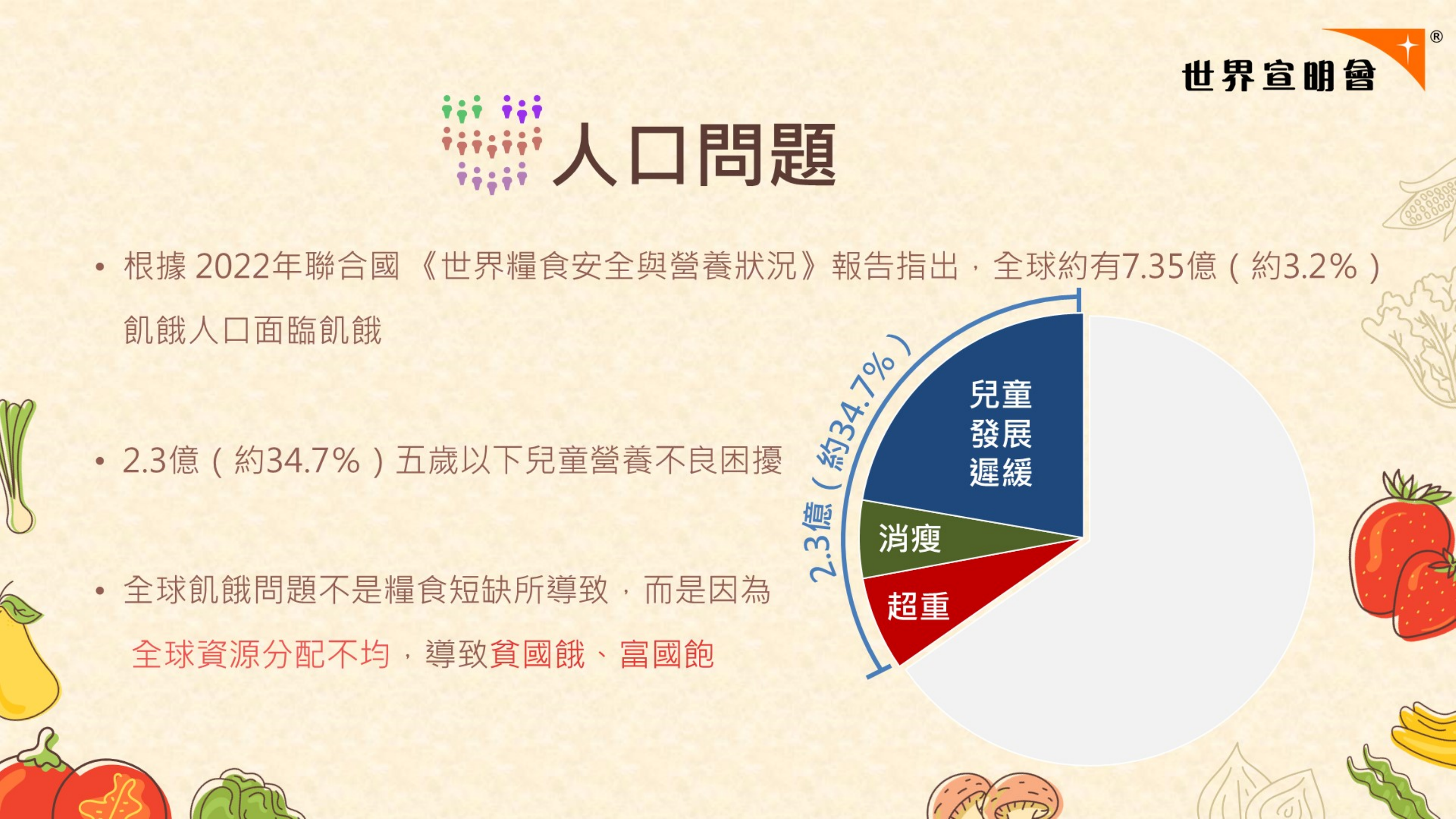
In the pie chart, which slice is larger: 超重 or 消瘦? 超重 What colour is the 兒童發展遲緩 slice in the pie chart? blue In the pie chart, which slice is larger: 兒童發展遲緩 or 超重? 兒童發展遲緩 What colour is the 超重 slice in the pie chart? red How many labelled slices does the pie chart have? 3 Which of the labelled slices in the pie chart is the smallest? 消瘦 According to the bracket label beside the pie chart, what total do the three coloured slices together represent? 2.3億（約34.7%） What kind of chart is shown on the right side of the slide? pie chart Which of the labelled slices in the pie chart is the largest? 兒童發展遲緩